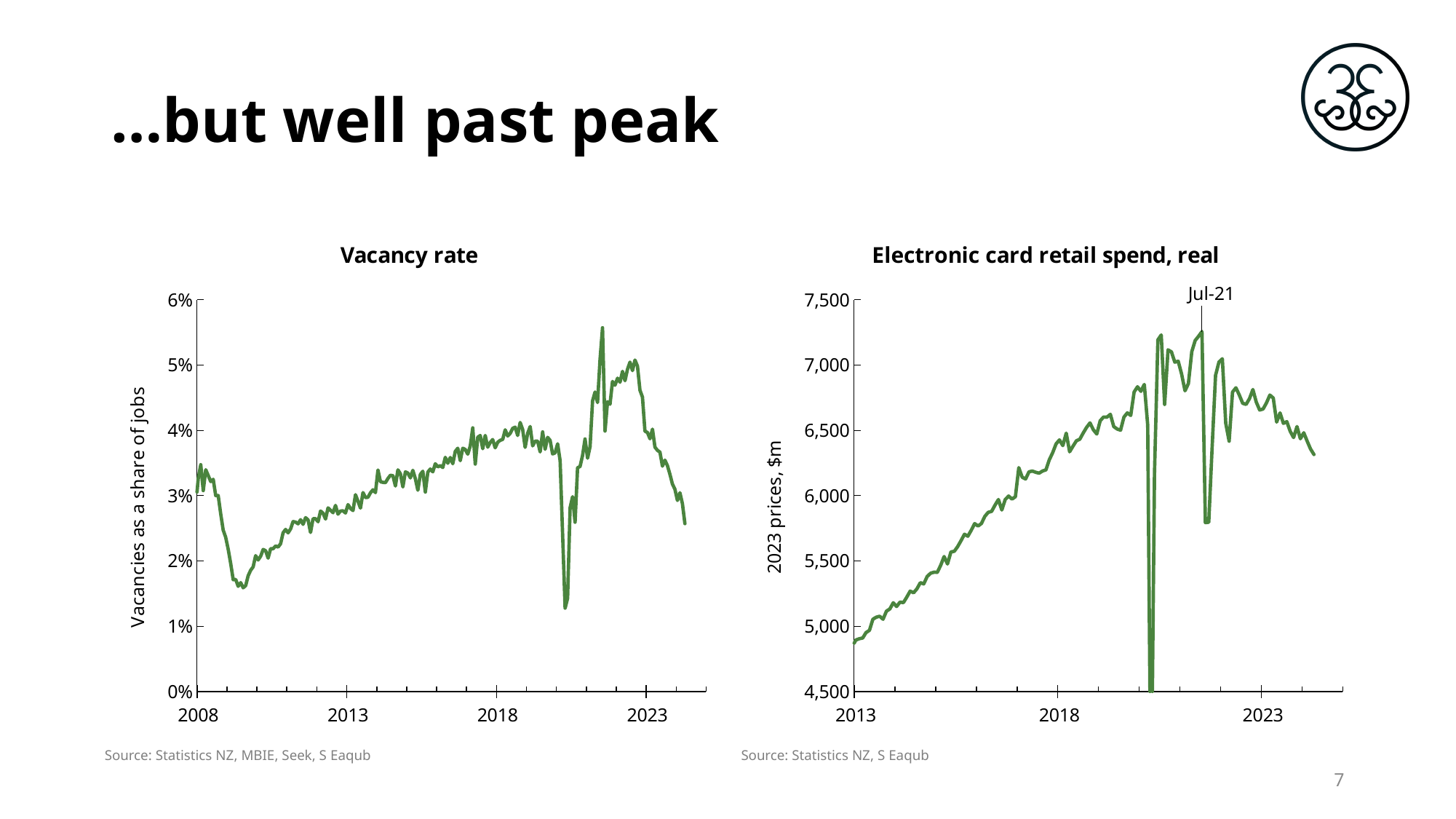
What kind of chart is the Electronic card retail spend, real chart? line chart On the Vacancy rate chart, is the value at the start of 2008 greater or less than 2%? greater What kind of chart is the Vacancy rate chart? line chart On the Electronic card retail spend, real chart, which month is labelled as the peak? Jul-21 On the Electronic card retail spend, real chart, is the value at the start of 2013 greater or less than 5,000? less On the Vacancy rate chart, is the lowest value in the sharp dip around 2020 greater or less than 2%? less What is the y-axis label on the Vacancy rate chart? Vacancies as a share of jobs On the Electronic card retail spend, real chart, does the line generally rise or fall between 2013 and 2018? rise On the Vacancy rate chart, does the line rise or fall from its peak around 2022 to the end of the series? fall